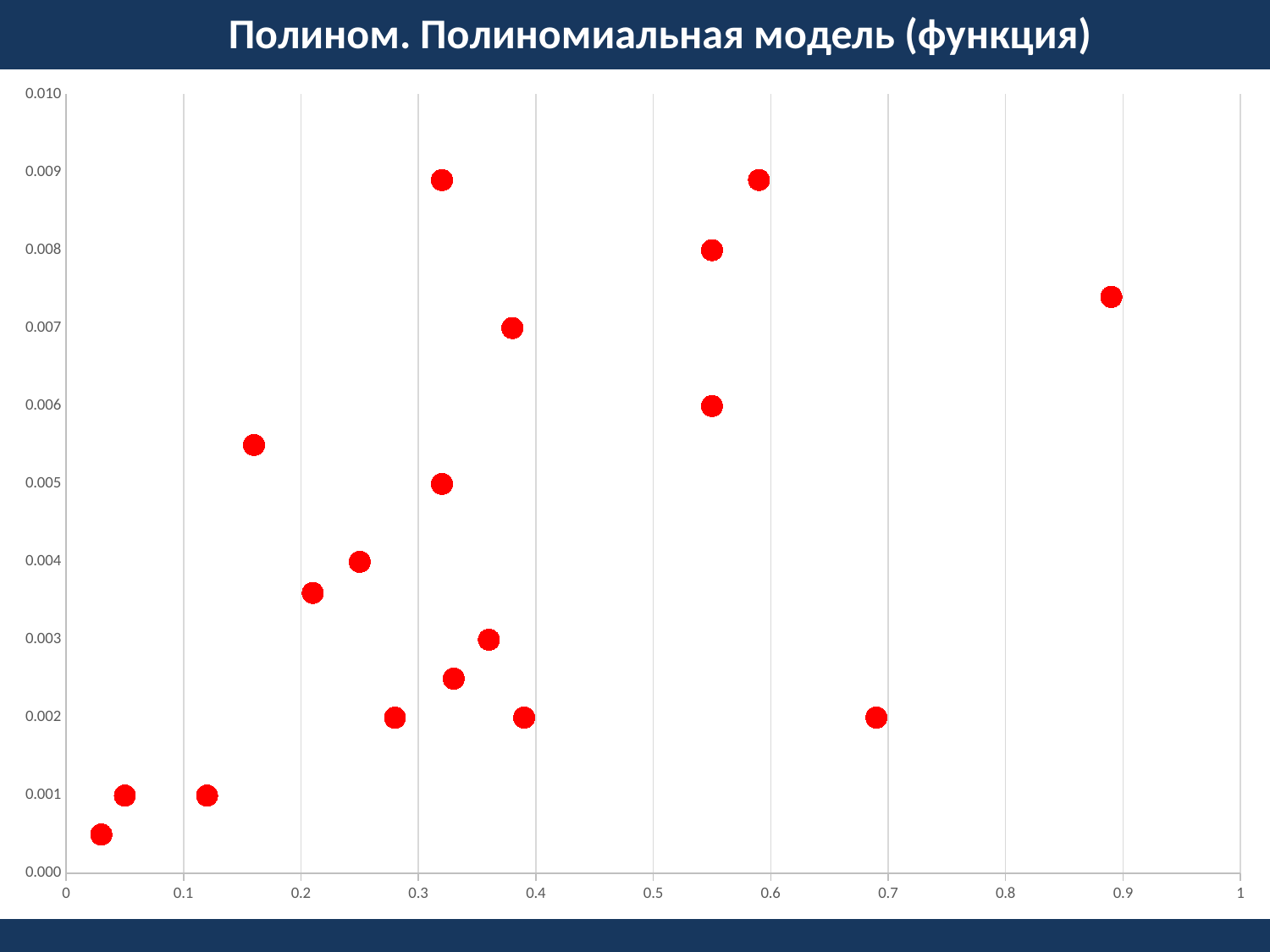
Is the y value of the rightmost point (at x ≈ 0.89) greater or less than 0.007? greater What colour are the data point markers on the chart? red What kind of chart is shown on the slide? scatter chart Which point has the higher y value: the one at x ≈ 0.12 or the one at x ≈ 0.16? the one at x ≈ 0.16 Is the y value of the point at x ≈ 0.69 greater or less than 0.003? less Is the y value of the point at x ≈ 0.38 greater or less than 0.006? greater What is the title of the chart on the slide? Полином. Полиномиальная модель (функция) How many data points are plotted on the chart? 18 What is the maximum value shown on the y axis? 0.010 Which point has the higher y value: the one at x ≈ 0.69 or the one at x ≈ 0.89? the one at x ≈ 0.89